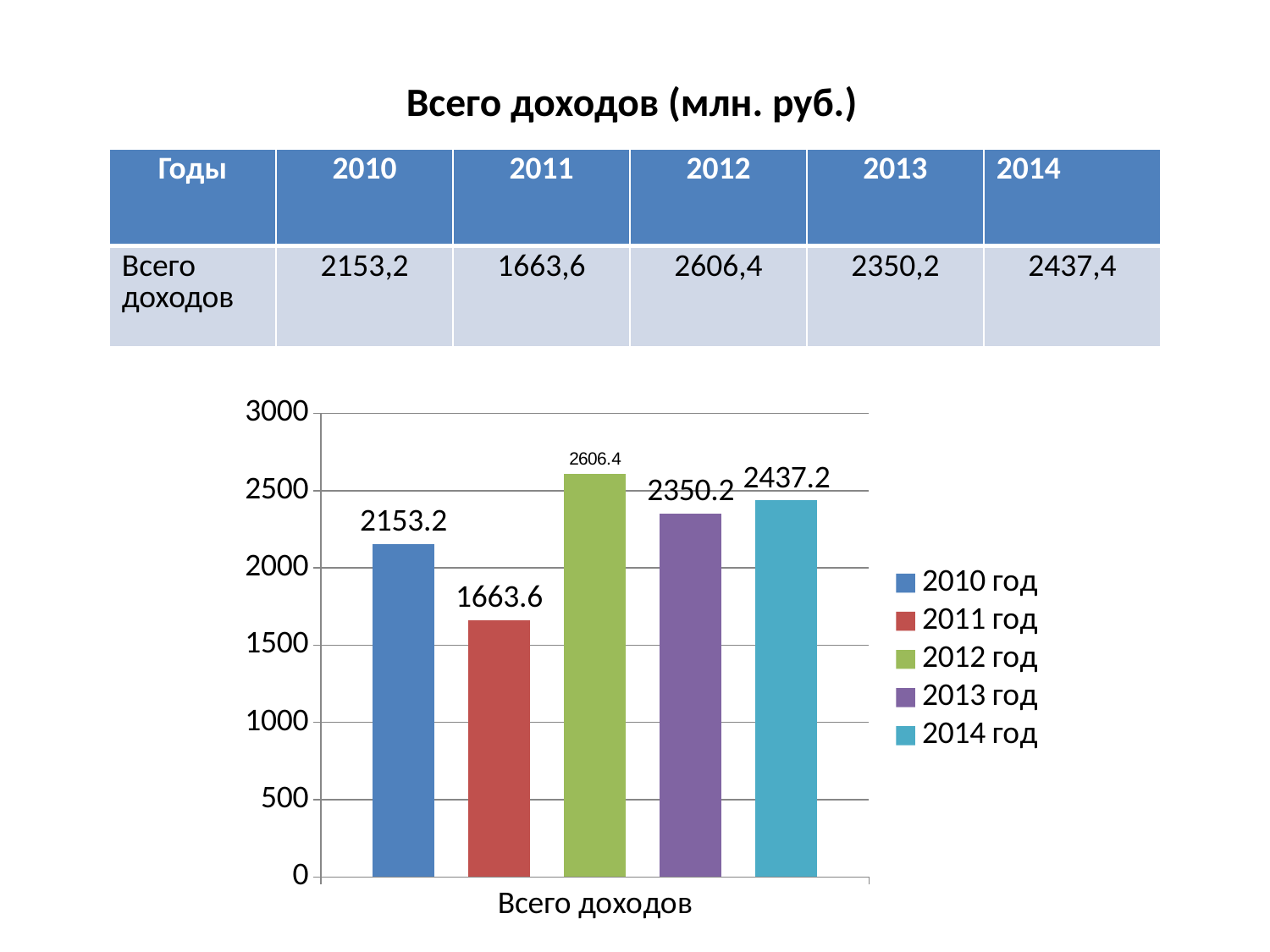
Which year has the highest bar in the chart? 2012 год Which year has the lowest bar in the chart? 2011 год What is the category label shown on the x axis of the chart? Всего доходов How many series does the chart legend list? 5 What is the difference between the 2010 год and 2011 год values in the chart? 489.6 What is the difference between the 2012 год and 2011 год values in the chart? 942.8 What is the value of the 2010 год bar in the chart? 2153.2 What is the value of the 2011 год bar in the chart? 1663.6 What type of chart is shown on the slide? bar chart What is the value of the 2012 год bar in the chart? 2606.4 Which is larger in the chart, the 2013 год bar or the 2010 год bar? 2013 год What is the value of the 2013 год bar in the chart? 2350.2